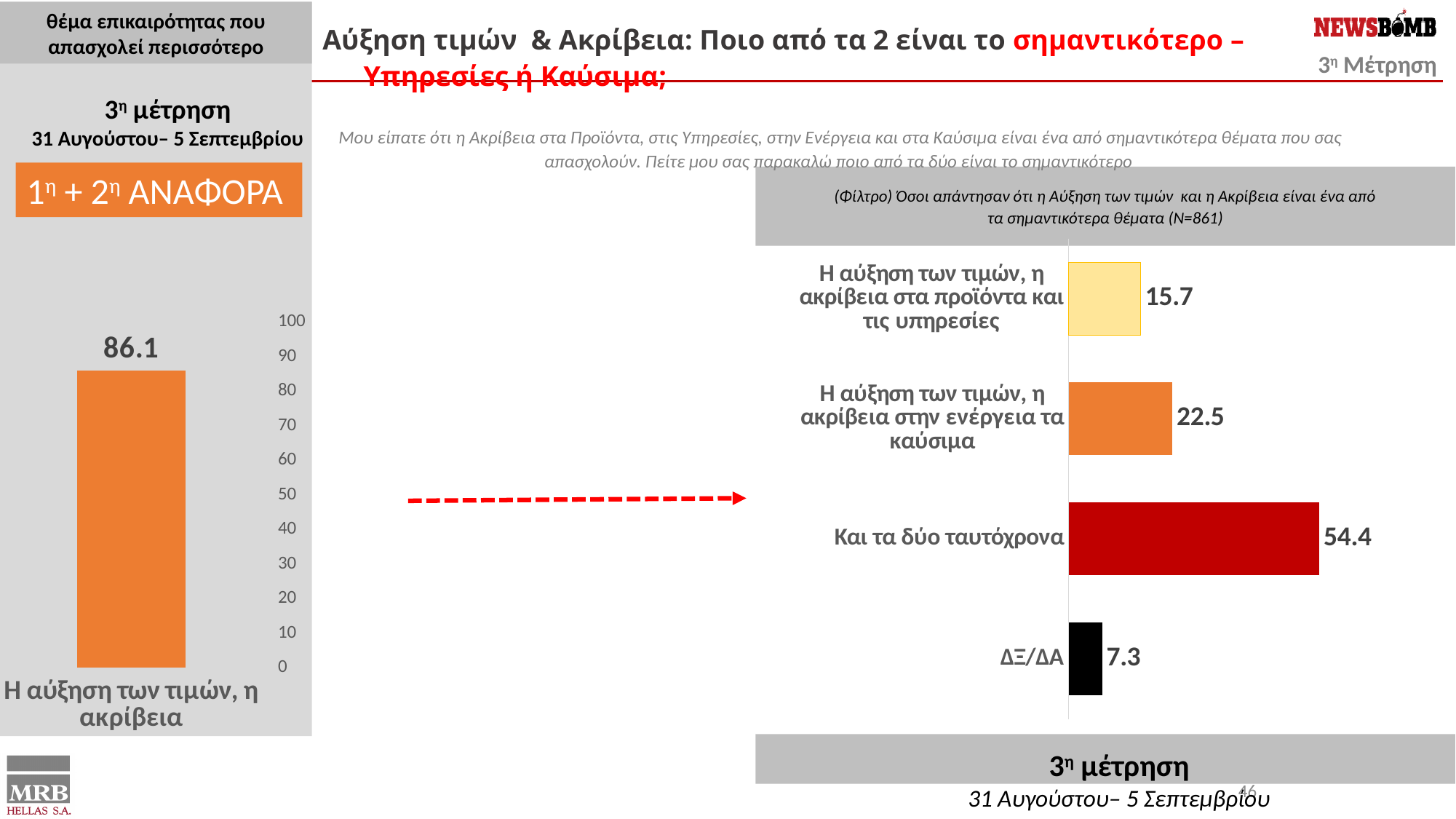
On the right chart, how many categories are plotted? 4 On the right chart, what is the value for 'Η αύξηση των τιμών, η ακρίβεια στα προϊόντα και τις υπηρεσίες'? 15.7 On the right chart, which is larger: the value for 'Η αύξηση των τιμών, η ακρίβεια στην ενέργεια τα καύσιμα' or for 'Η αύξηση των τιμών, η ακρίβεια στα προϊόντα και τις υπηρεσίες'? Η αύξηση των τιμών, η ακρίβεια στην ενέργεια τα καύσιμα On the right chart, what is the value for 'Και τα δύο ταυτόχρονα'? 54.4 On the left chart, is the value for 'Η αύξηση των τιμών, η ακρίβεια' greater or less than 80? greater On the right chart, what is the value for 'Η αύξηση των τιμών, η ακρίβεια στην ενέργεια τα καύσιμα'? 22.5 On the right chart, which category has the highest value? Και τα δύο ταυτόχρονα On the right chart, what is the difference between 'Και τα δύο ταυτόχρονα' and 'Η αύξηση των τιμών, η ακρίβεια στην ενέργεια τα καύσιμα'? 31.9 On the right chart, which category has the lowest value? ΔΞ/ΔΑ On the right chart, what is the value for 'ΔΞ/ΔΑ'? 7.3 On the left chart, what is the value shown for 'Η αύξηση των τιμών, η ακρίβεια'? 86.1 On the left chart, how many bars are plotted? 1